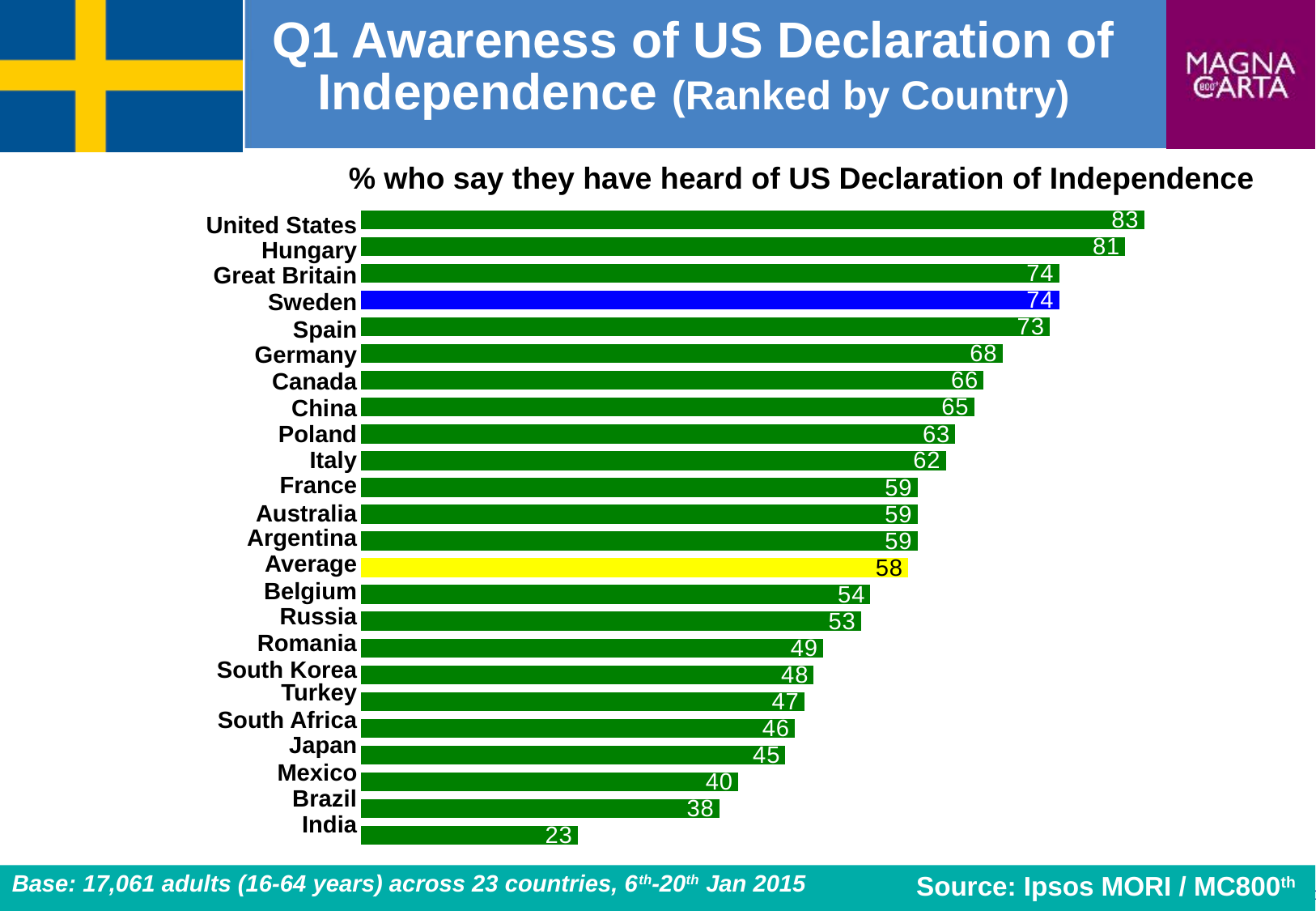
What is the value shown for Average? 58 Which country has the lowest value? India What is the difference between the values for Sweden and the Average? 16 What is the value for Germany? 68 What is the value for Sweden? 74 Which country has the highest value? United States How many bars are shown in the chart, including the Average? 24 Which has a larger value, Canada or Poland? Canada What is the difference between the values for United States and Hungary? 2 What is the value for India? 23 Which bar is coloured blue? Sweden What kind of chart is shown? Bar chart